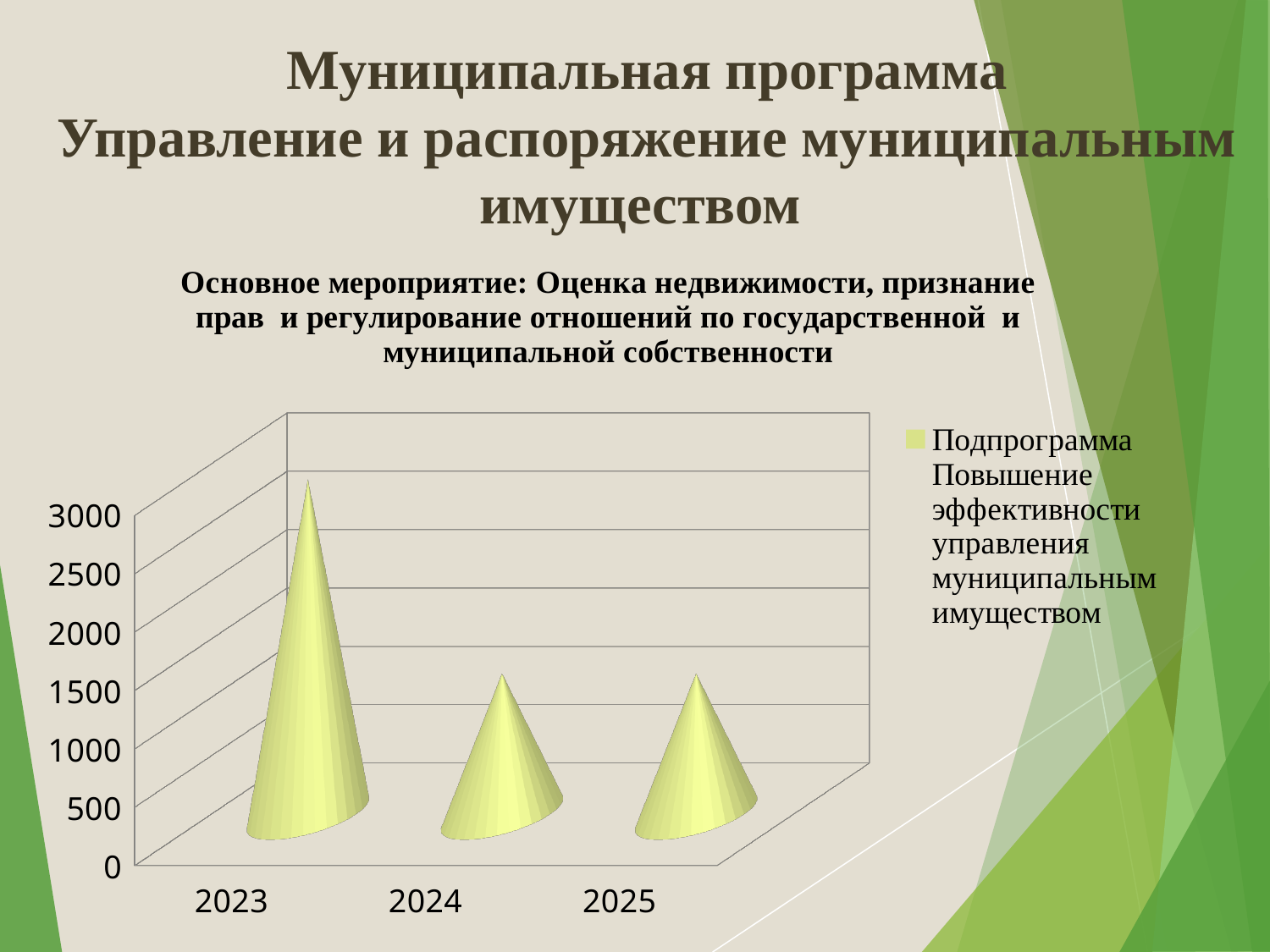
Is the value for 2025 greater or less than 2000? less How many series does the chart legend list? 1 Is the value for 2023 greater or less than 2500? greater Which year has the highest value in the chart? 2023 What kind of chart is shown on the slide? bar chart What series name is shown in the chart legend? Подпрограмма Повышение эффективности управления муниципальным имуществом Is the value for 2024 greater or less than 2500? less What is the first year shown on the x axis of the chart? 2023 Which is larger, the value for 2023 or the value for 2025? 2023 Does the value rise or fall from 2023 to 2024? falls Which is larger, the value for 2023 or the value for 2024? 2023 How many categories are shown on the x axis of the chart? 3